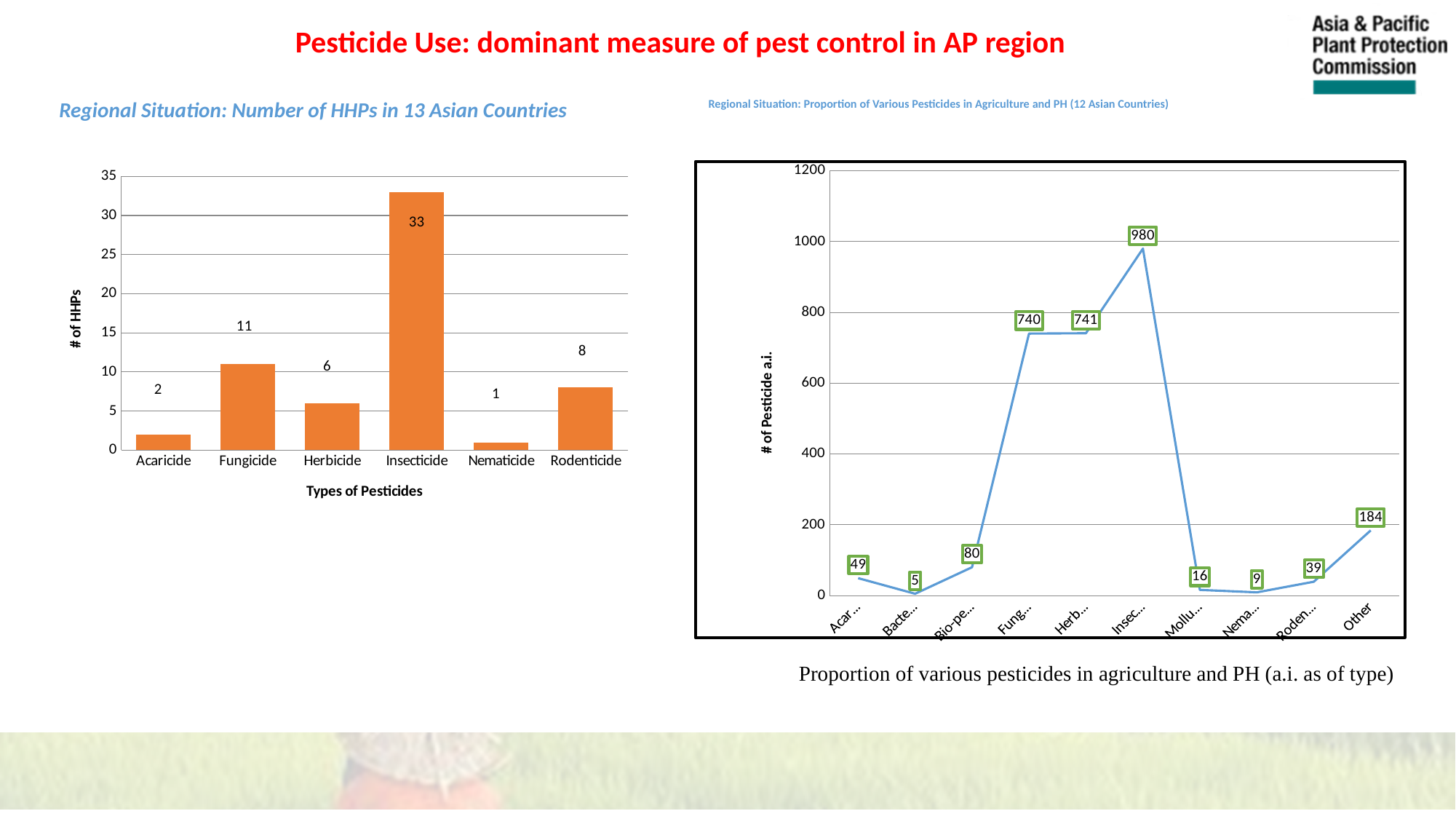
What kind of chart is the right chart (Proportion of Various Pesticides in Agriculture and PH)? Line chart In the right chart (Proportion of Various Pesticides in Agriculture and PH), what is the lowest value plotted? 5 In the left chart (Number of HHPs in 13 Asian Countries), which type of pesticide has the lowest number of HHPs? Nematicide In the right chart (Proportion of Various Pesticides in Agriculture and PH), how many data points are plotted on the line? 10 In the left chart (Number of HHPs in 13 Asian Countries), how many HHPs are shown for Fungicide? 11 In the left chart (Number of HHPs in 13 Asian Countries), what is the difference between the number of HHPs for Rodenticide and Herbicide? 2 In the left chart (Number of HHPs in 13 Asian Countries), how many HHPs are shown for Insecticide? 33 In the right chart (Proportion of Various Pesticides in Agriculture and PH), what is the value for the category labelled 'Other'? 184 In the left chart (Number of HHPs in 13 Asian Countries), which type of pesticide has the highest number of HHPs? Insecticide What kind of chart is the left chart (Number of HHPs in 13 Asian Countries)? Bar chart In the right chart (Proportion of Various Pesticides in Agriculture and PH), what is the highest value plotted? 980 In the left chart (Number of HHPs in 13 Asian Countries), how many types of pesticides are shown on the x axis? 6